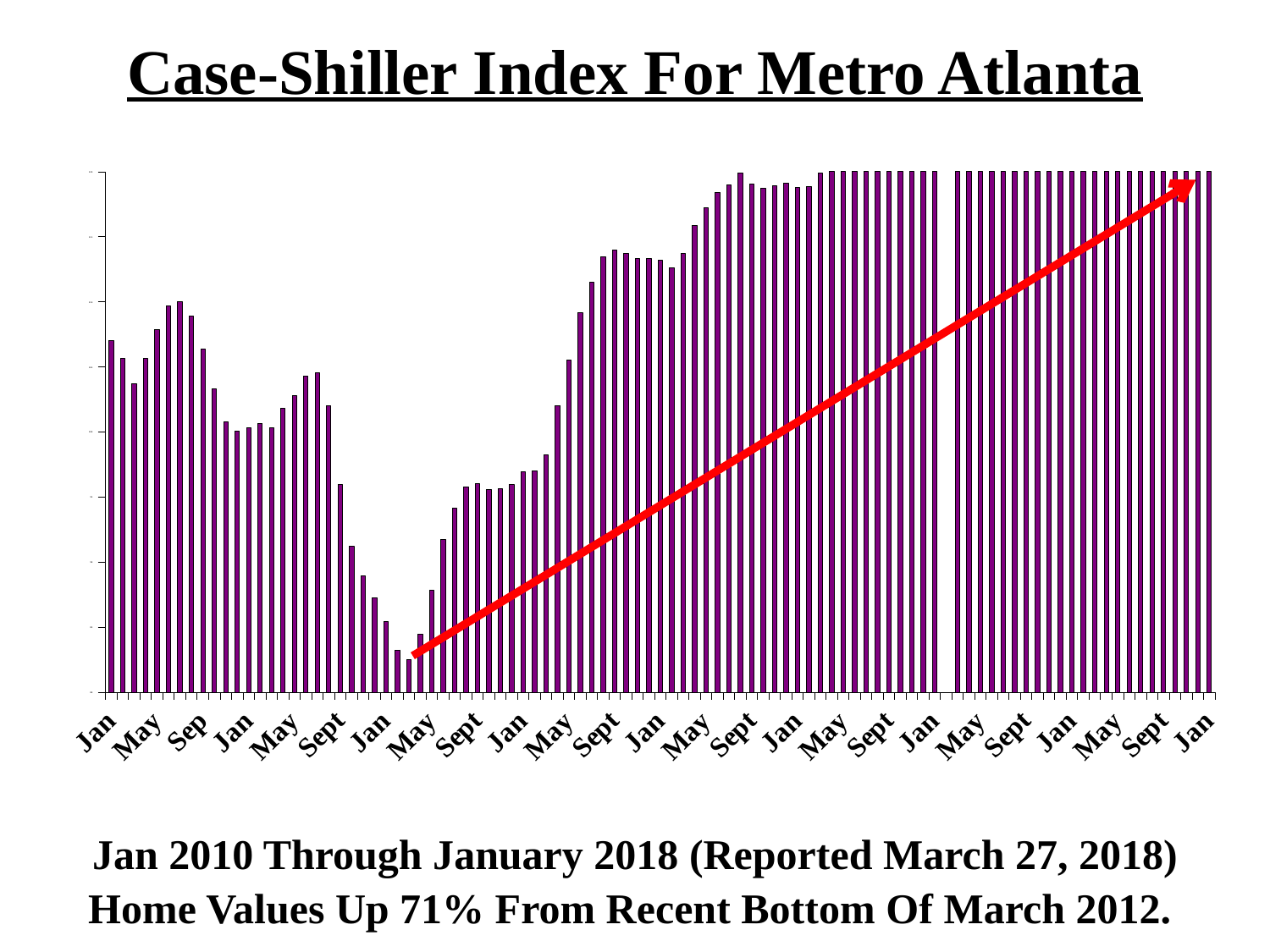
Does the index rise or fall from January 2010 to January 2012? Fall Which is higher, the index in September 2013 or in September 2012? September 2013 Which is higher, the index in September 2010 or in September 2011? September 2010 Does the index rise or fall from March 2012 to January 2018? Rise Which is higher, the index in May 2012 or in May 2013? May 2013 What kind of chart is shown on the slide? Bar chart In which month and year does the index reach its lowest point on the chart? March 2012 What is the title of the chart? Case-Shiller Index For Metro Atlanta According to the slide, by what percentage are home values up from the recent bottom of March 2012? 71%